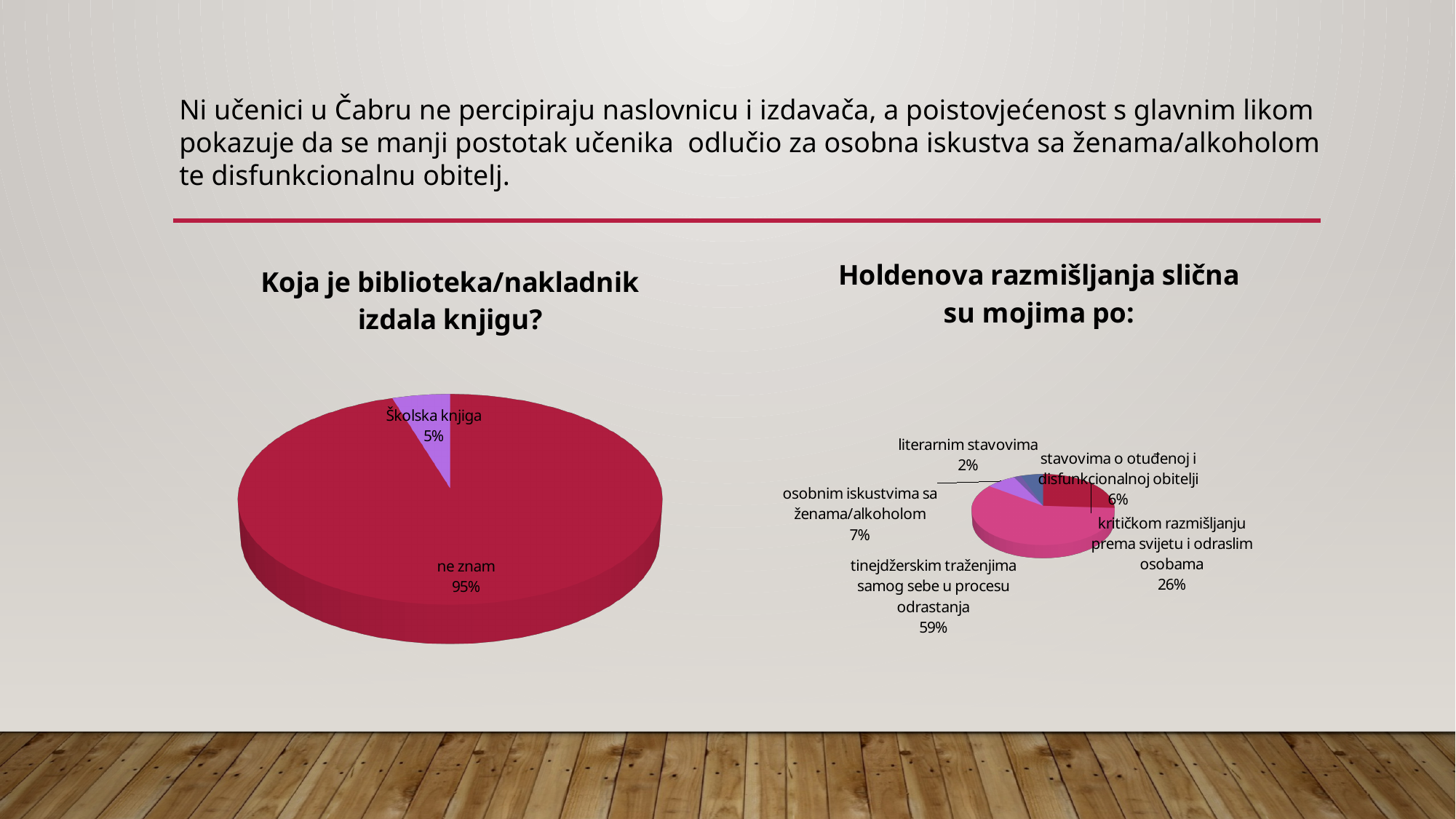
In the chart titled "Holdenova razmišljanja slična su mojima po:", which category has the largest share? tinejdžerskim traženjima samog sebe u procesu odrastanja In the chart titled "Holdenova razmišljanja slična su mojima po:", what share is labelled "tinejdžerskim traženjima samog sebe u procesu odrastanja"? 59% In the chart titled "Koja je biblioteka/nakladnik izdala knjigu?", what share is labelled "ne znam"? 95% In the chart titled "Holdenova razmišljanja slična su mojima po:", what share is labelled "osobnim iskustvima sa ženama/alkoholom"? 7% In the chart titled "Koja je biblioteka/nakladnik izdala knjigu?", what share is labelled "Školska knjiga"? 5% In the chart titled "Koja je biblioteka/nakladnik izdala knjigu?", what is the difference between the "ne znam" and "Školska knjiga" shares? 90% In the chart titled "Holdenova razmišljanja slična su mojima po:", which is larger: "stavovima o otuđenoj i disfunkcionalnoj obitelji" or "osobnim iskustvima sa ženama/alkoholom"? osobnim iskustvima sa ženama/alkoholom In the chart titled "Holdenova razmišljanja slična su mojima po:", how many categories are shown? 5 In the chart titled "Koja je biblioteka/nakladnik izdala knjigu?", how many slices does the pie have? 2 In the chart titled "Holdenova razmišljanja slična su mojima po:", which category has the smallest share? literarnim stavovima What kind of chart is the chart titled "Koja je biblioteka/nakladnik izdala knjigu?"? Pie chart In the chart titled "Holdenova razmišljanja slična su mojima po:", what share is labelled "kritičkom razmišljanju prema svijetu i odraslim osobama"? 26%